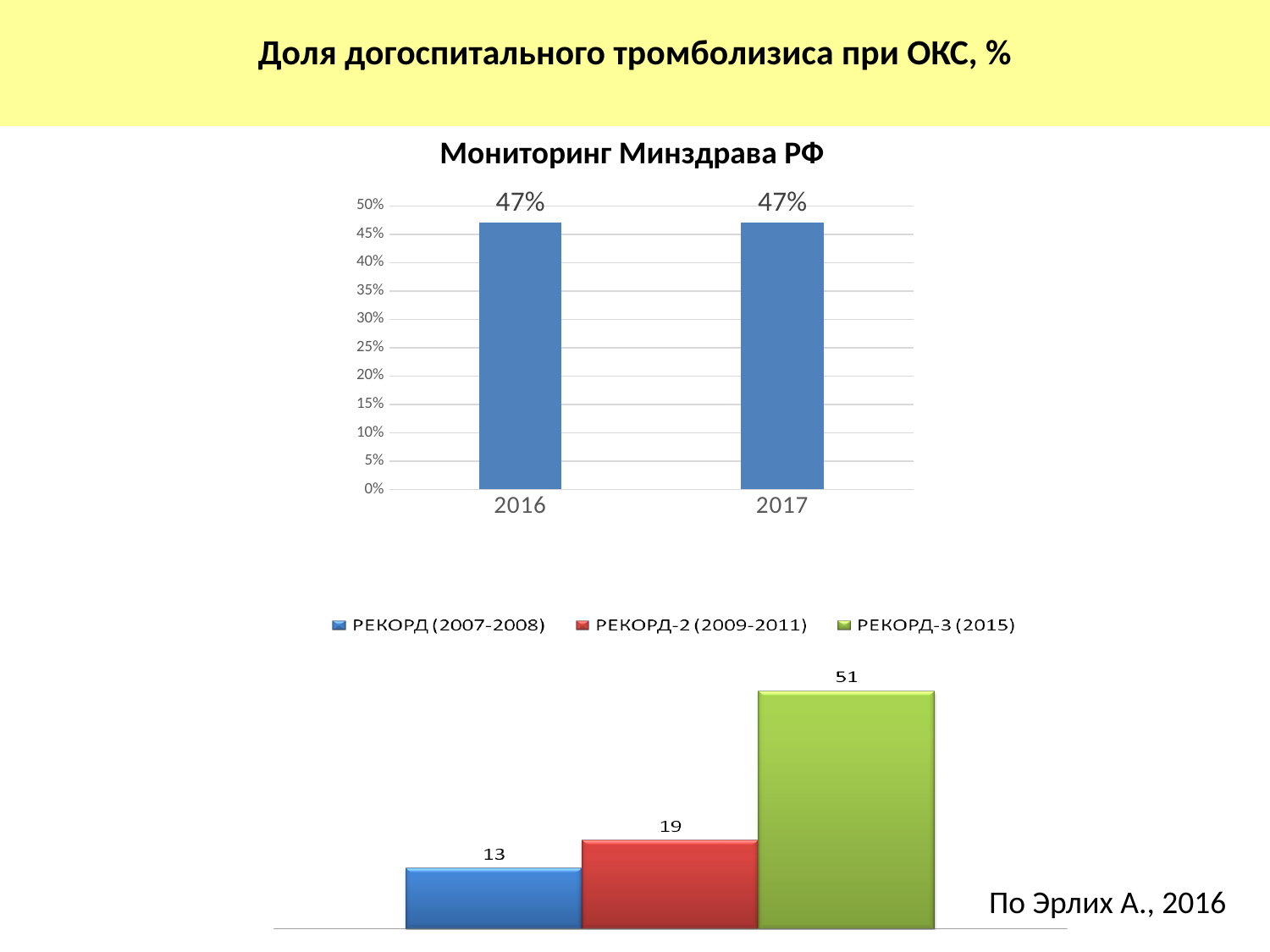
In the bottom chart, what is the difference between the values for РЕКОРД-3 (2015) and РЕКОРД (2007-2008)? 38 In the bottom chart, which series has the lowest value? РЕКОРД (2007-2008) In the bottom chart, what is the value for РЕКОРД-3 (2015)? 51 In the top chart titled 'Мониторинг Минздрава РФ', what is the value for 2016? 47% In the top chart titled 'Мониторинг Минздрава РФ', what is the difference between the 2016 and 2017 values? 0% In the top chart titled 'Мониторинг Минздрава РФ', what is the value for 2017? 47% How many series does the legend of the bottom chart list? 3 In the bottom chart, which series has the highest value? РЕКОРД-3 (2015) In the top chart titled 'Мониторинг Минздрава РФ', how many bars are plotted? 2 What kind of chart is the top chart titled 'Мониторинг Минздрава РФ'? bar chart In the bottom chart, what is the value for РЕКОРД (2007-2008)? 13 In the bottom chart, what is the value for РЕКОРД-2 (2009-2011)? 19